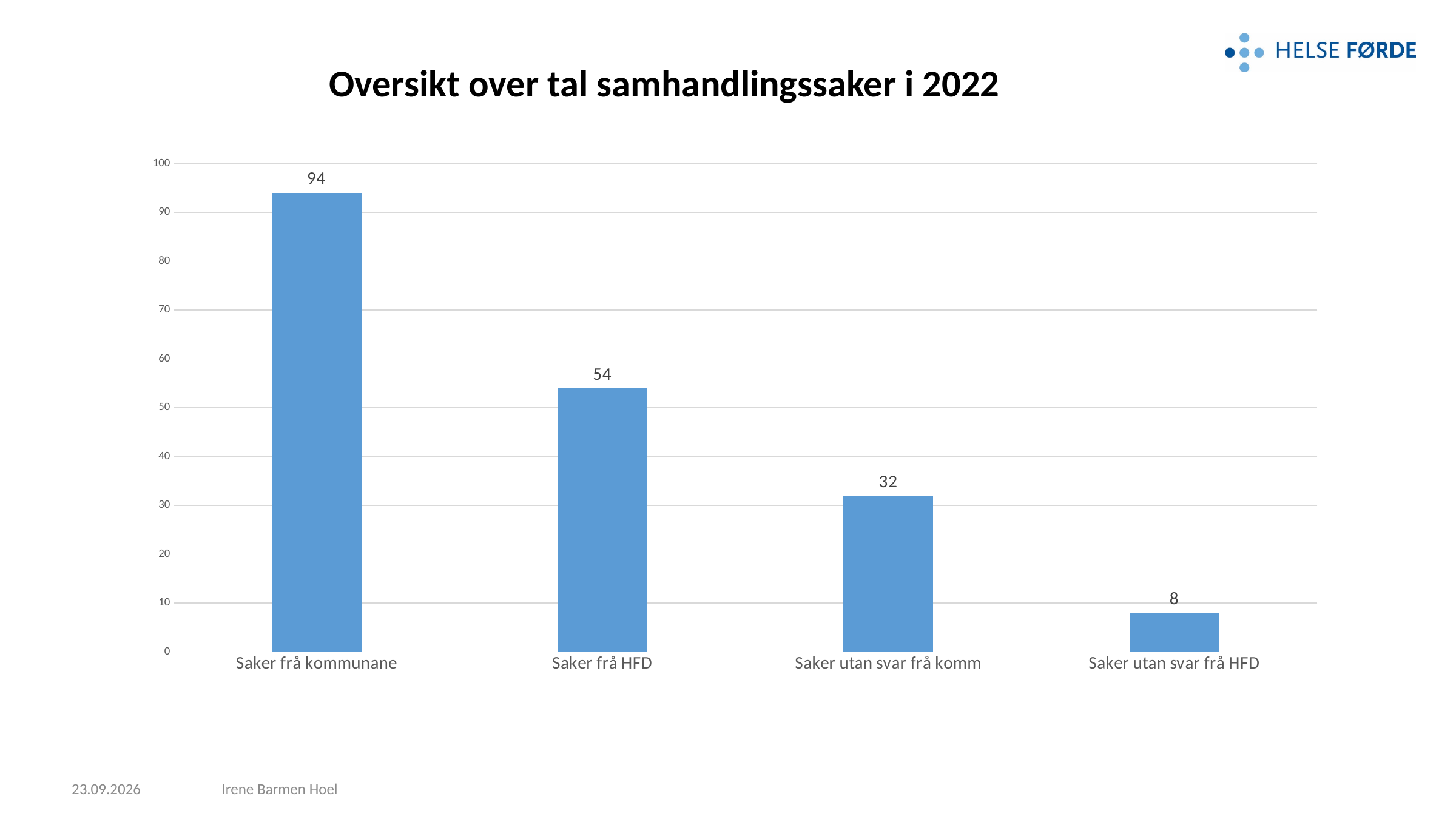
What is the value for Saker utan svar frå komm? 32 Is the value for Saker utan svar frå komm greater or less than 40? less Which is larger, Saker frå HFD or Saker utan svar frå komm? Saker frå HFD What is the value for Saker frå HFD? 54 What is the value for Saker frå kommunane? 94 What kind of chart is shown on the slide? bar chart What is the difference between Saker frå kommunane and Saker frå HFD? 40 Which category has the lowest value? Saker utan svar frå HFD What is the title of the chart? Oversikt over tal samhandlingssaker i 2022 What is the value for Saker utan svar frå HFD? 8 Which category has the highest value? Saker frå kommunane How many categories are shown on the x axis? 4